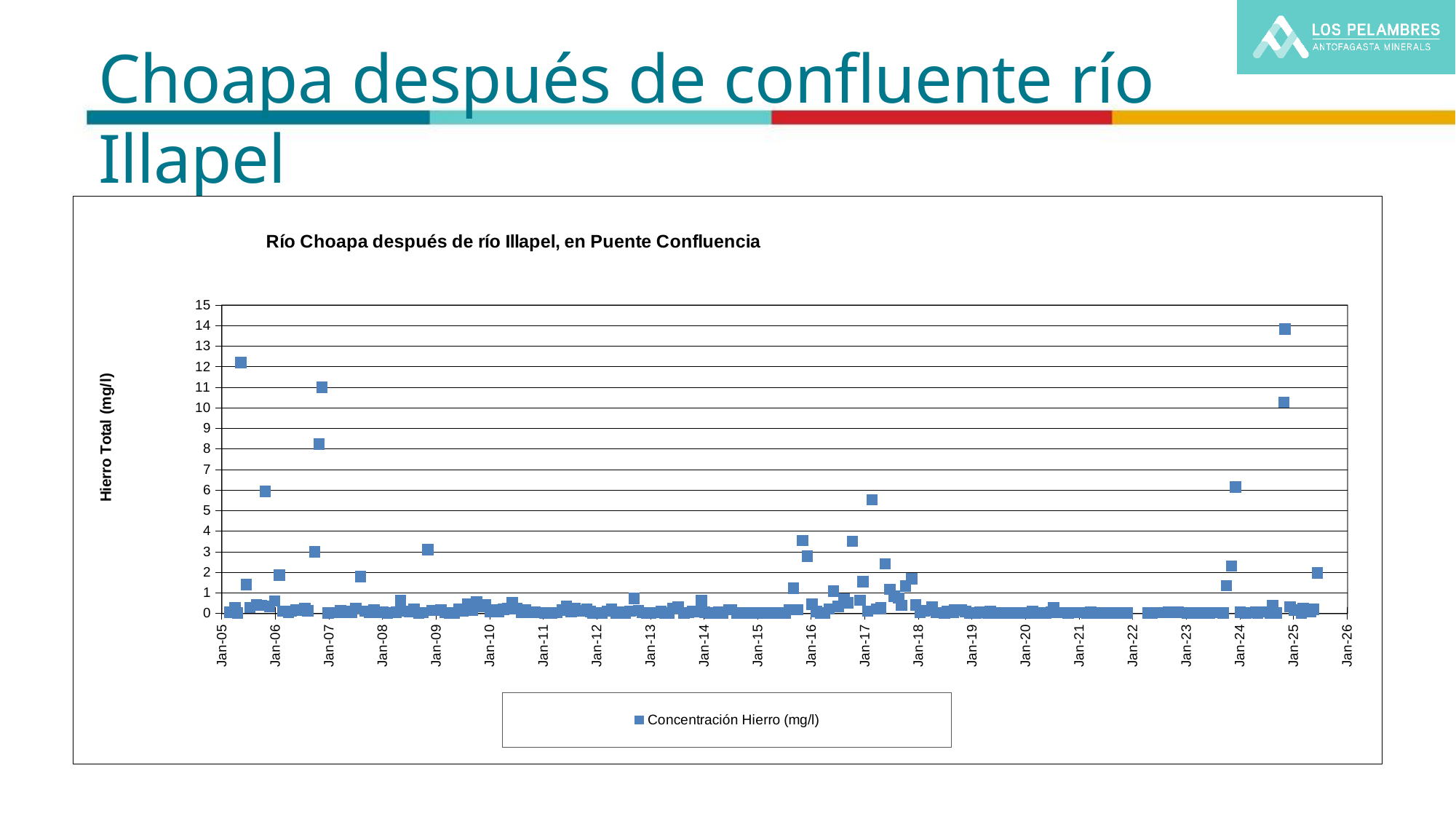
Is the highest point near Jan-05 greater or less than 10 mg/l? greater What is the title of the chart? Río Choapa después de río Illapel, en Puente Confluencia What is the first date label on the horizontal axis? Jan-05 Around which x-axis label does the highest point of the series occur? Jan-25 What is the label of the vertical axis? Hierro Total (mg/l) Is the highest point near Jan-17 greater or less than 6 mg/l? less Is the highest point near Jan-25 greater or less than 13 mg/l? greater What is the last date label on the horizontal axis? Jan-26 How many series does the legend list? 1 What is the name of the series shown in the legend? Concentración Hierro (mg/l) What is the maximum value shown on the vertical axis? 15 What kind of chart is shown on the slide? Scatter chart